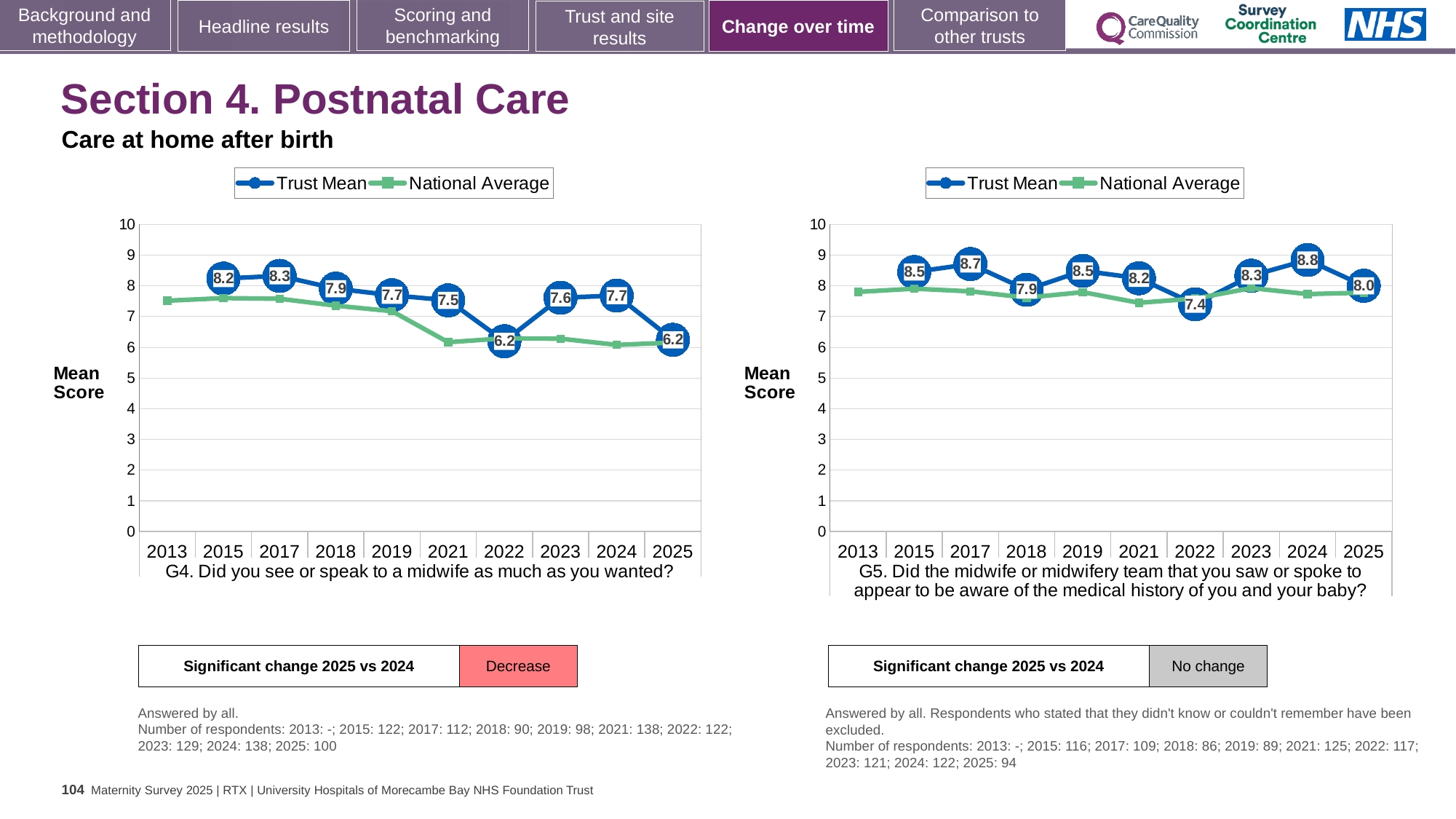
In the G5 chart (right), which year has the lowest Trust Mean score? 2022 In the G4 chart (left), is the National Average value for 2013 greater or less than 7? greater What kind of chart is the G4 chart (left)? Line chart In the G5 chart (right), what is the Trust Mean score for 2024? 8.8 How many series does the legend of the G4 chart (left) list? 2 In the G5 chart (right), which is larger: the Trust Mean score for 2017 or for 2019? 2017 In the G4 chart (left), what is the difference between the Trust Mean scores for 2024 and 2025? 1.5 In the G4 chart (left), which year has the highest Trust Mean score? 2017 In the G5 chart (right), is the National Average value for 2022 greater or less than 8? less In the G4 chart (left), what is the Trust Mean score for 2025? 6.2 How many years are shown on the x axis of the G5 chart (right)? 10 In the G4 chart (left), does the Trust Mean score rise or fall from 2024 to 2025? Fall